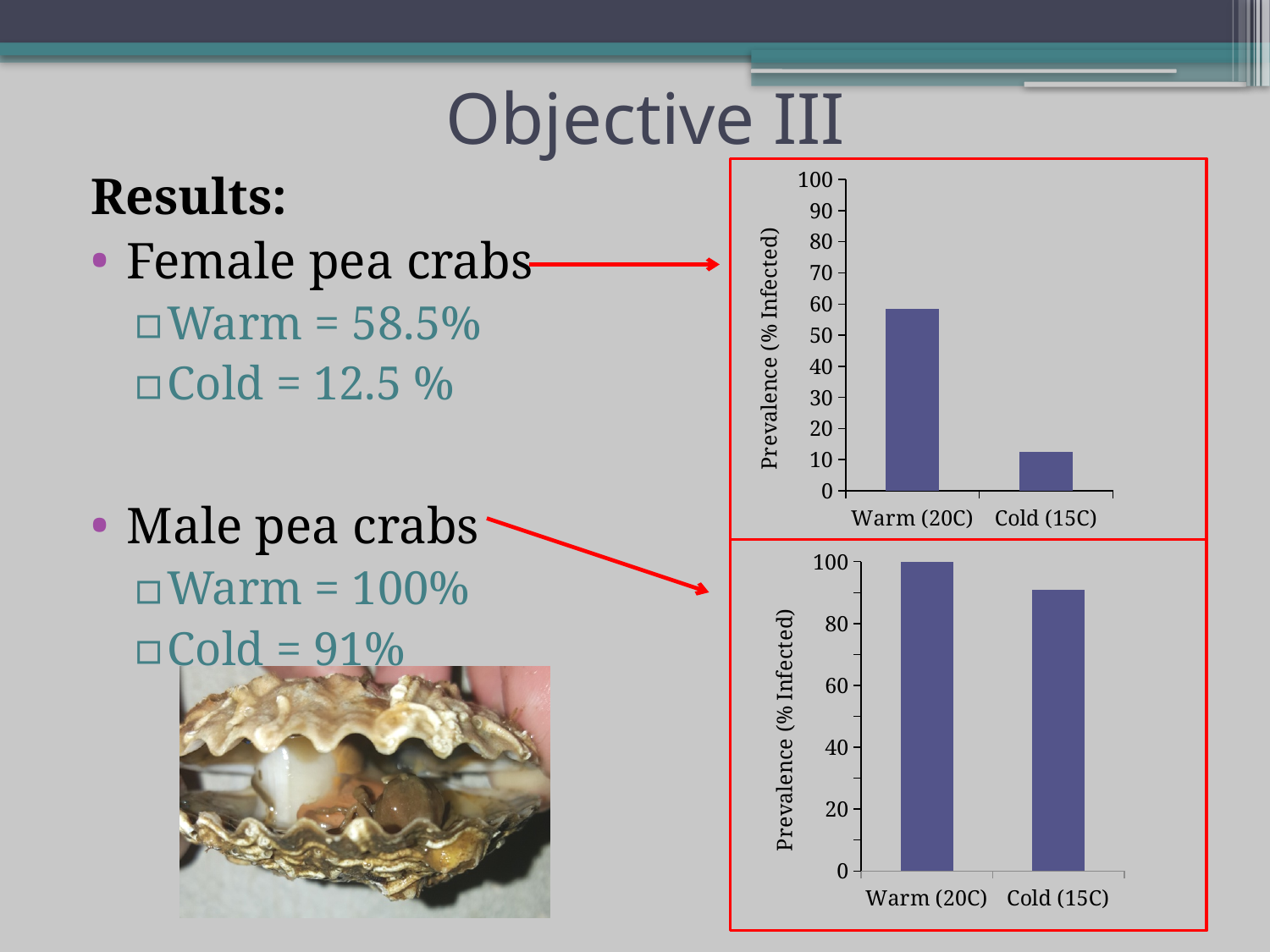
In the bottom chart (male pea crabs), what is the prevalence for Cold (15C)? 91% In the bottom chart (male pea crabs), what is the prevalence for Warm (20C)? 100% In the top chart, which category has the highest prevalence? Warm (20C) What is the y-axis label of the bottom chart? Prevalence (% Infected) How many categories does the bottom chart show? 2 In the top chart (female pea crabs), what is the prevalence for Warm (20C)? 58.5% In the top chart, is the value for Cold (15C) greater or less than 20? less In the bottom chart, is the value for Cold (15C) greater or less than 80? greater In the bottom chart, which category has the lowest prevalence? Cold (15C) In the top chart (female pea crabs), what is the prevalence for Cold (15C)? 12.5 % What kind of chart is the top chart on the slide? bar chart In the top chart, which is larger: the value for Warm (20C) or Cold (15C)? Warm (20C)